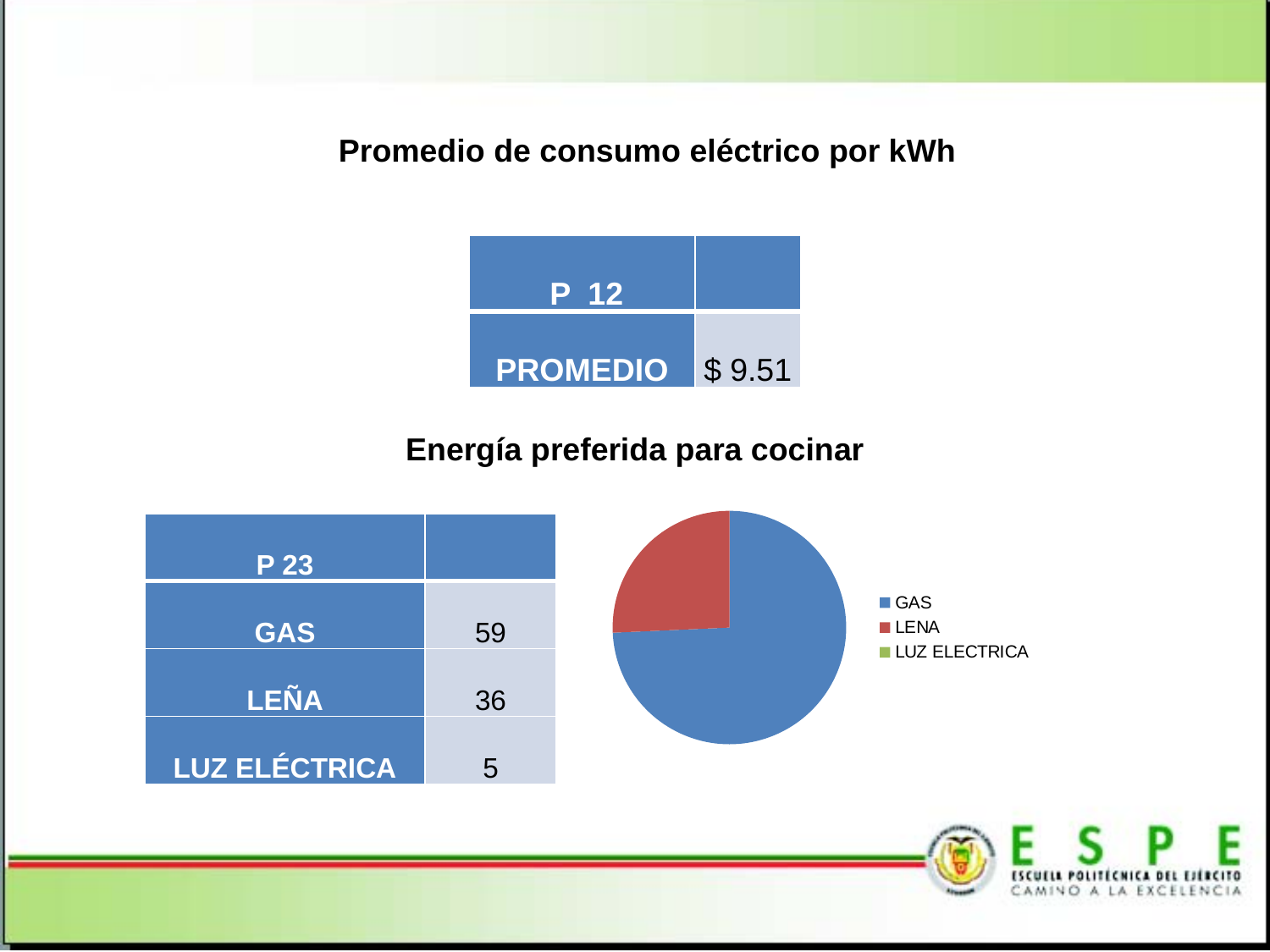
Which category has the largest slice in the pie chart? GAS What kind of chart is shown under the title "Energía preferida para cocinar"? pie chart Which colour represents LENA in the pie chart? red Is the slice for GAS larger or smaller than the slice for LENA? larger Using the table values, what is the difference between GAS and LEÑA? 23 According to the table next to the pie chart, what is the value for GAS? 59 How many categories are shown in the pie chart's legend? 3 Which colour represents GAS in the pie chart? blue According to the table next to the pie chart, what is the value for LEÑA? 36 How many entries does the legend of the pie chart list? 3 According to the table next to the pie chart, what is the value for LUZ ELÉCTRICA? 5